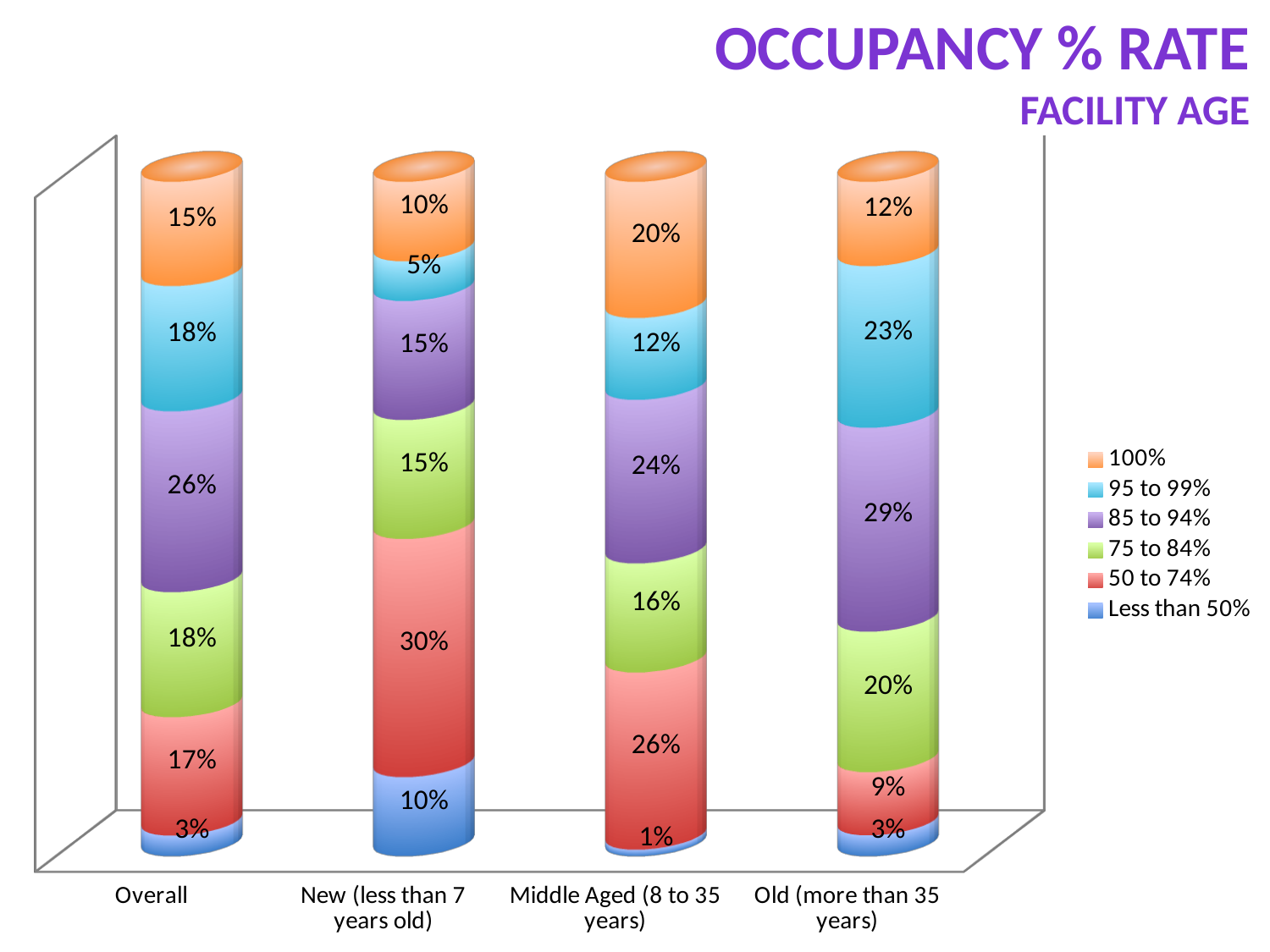
What is the value of the 50 to 74% segment for the New (less than 7 years old) category? 30% What is the title of the chart? OCCUPANCY % RATE FACILITY AGE Which is larger: the 75 to 84% value for Old (more than 35 years) or for Middle Aged (8 to 35 years)? Old (more than 35 years) Which category has the highest value for the 95 to 99% series? Old (more than 35 years) What is the value of the 85 to 94% segment for the Old (more than 35 years) category? 29% What is the difference between the 50 to 74% values for New (less than 7 years old) and Old (more than 35 years)? 21% Which category has the lowest value for the 100% series? New (less than 7 years old) How many series does the legend list? 6 What is the value of the 100% segment for the Overall category? 15% What type of chart is shown on the slide? stacked bar chart How many facility age categories are shown on the x axis? 4 What is the value of the Less than 50% segment for the Middle Aged (8 to 35 years) category? 1%